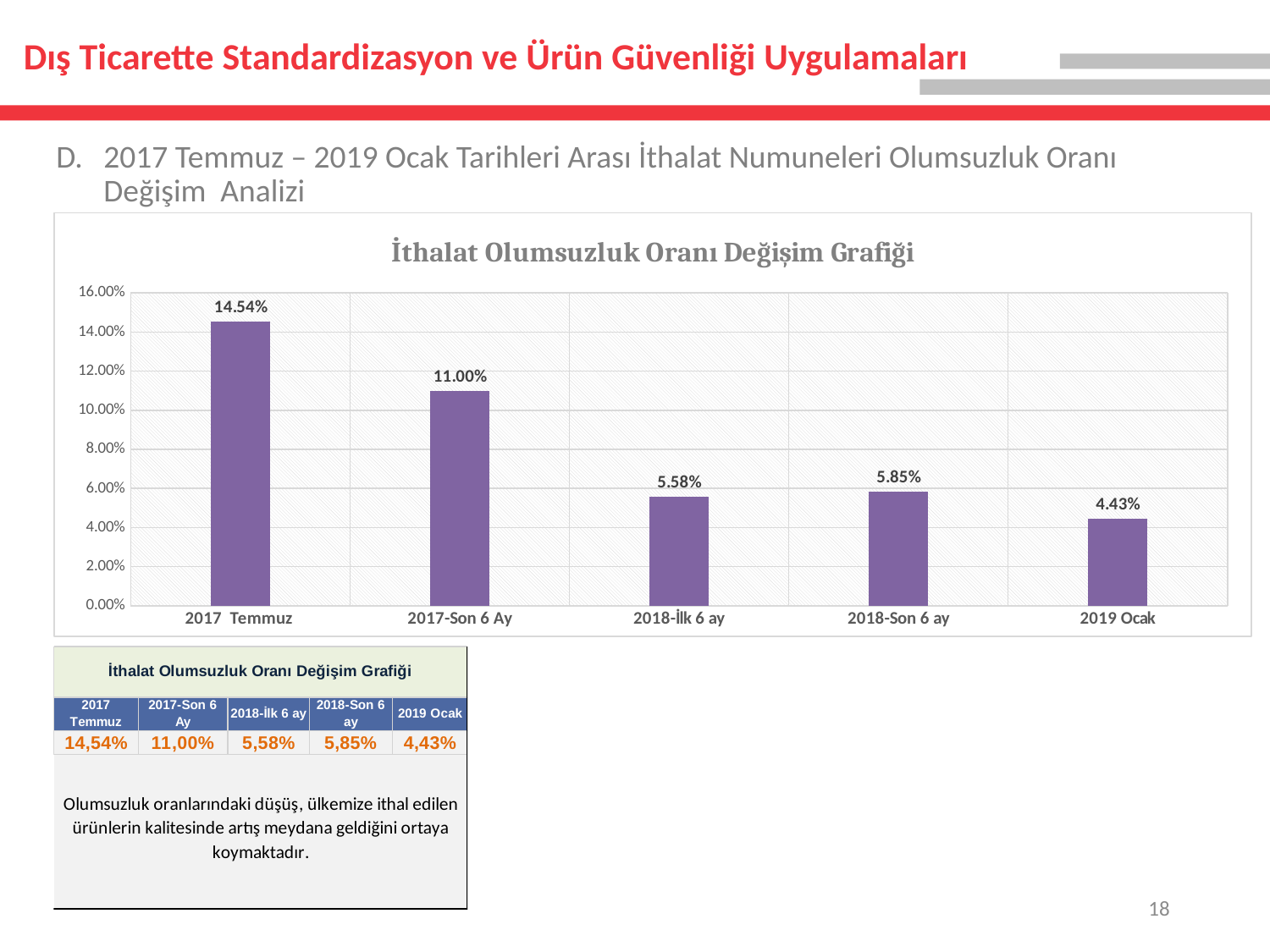
What is the value for 2017 Temmuz? 14.54% Which category has the highest value? 2017 Temmuz What is the value for 2019 Ocak? 4.43% What is the difference between the values for 2018-Son 6 ay and 2018-İlk 6 ay? 0.27% What is the value for 2018-Son 6 ay? 5.85% What kind of chart is shown on the slide? bar chart Which is larger, the value for 2017-Son 6 Ay or the value for 2018-İlk 6 ay? 2017-Son 6 Ay What is the title of the chart? İthalat Olumsuzluk Oranı Değişim Grafiği How many categories are shown on the x axis? 5 Is the value for 2018-İlk 6 ay greater or less than 6.00%? less What is the difference between the values for 2017 Temmuz and 2017-Son 6 Ay? 3.54% Which category has the lowest value? 2019 Ocak